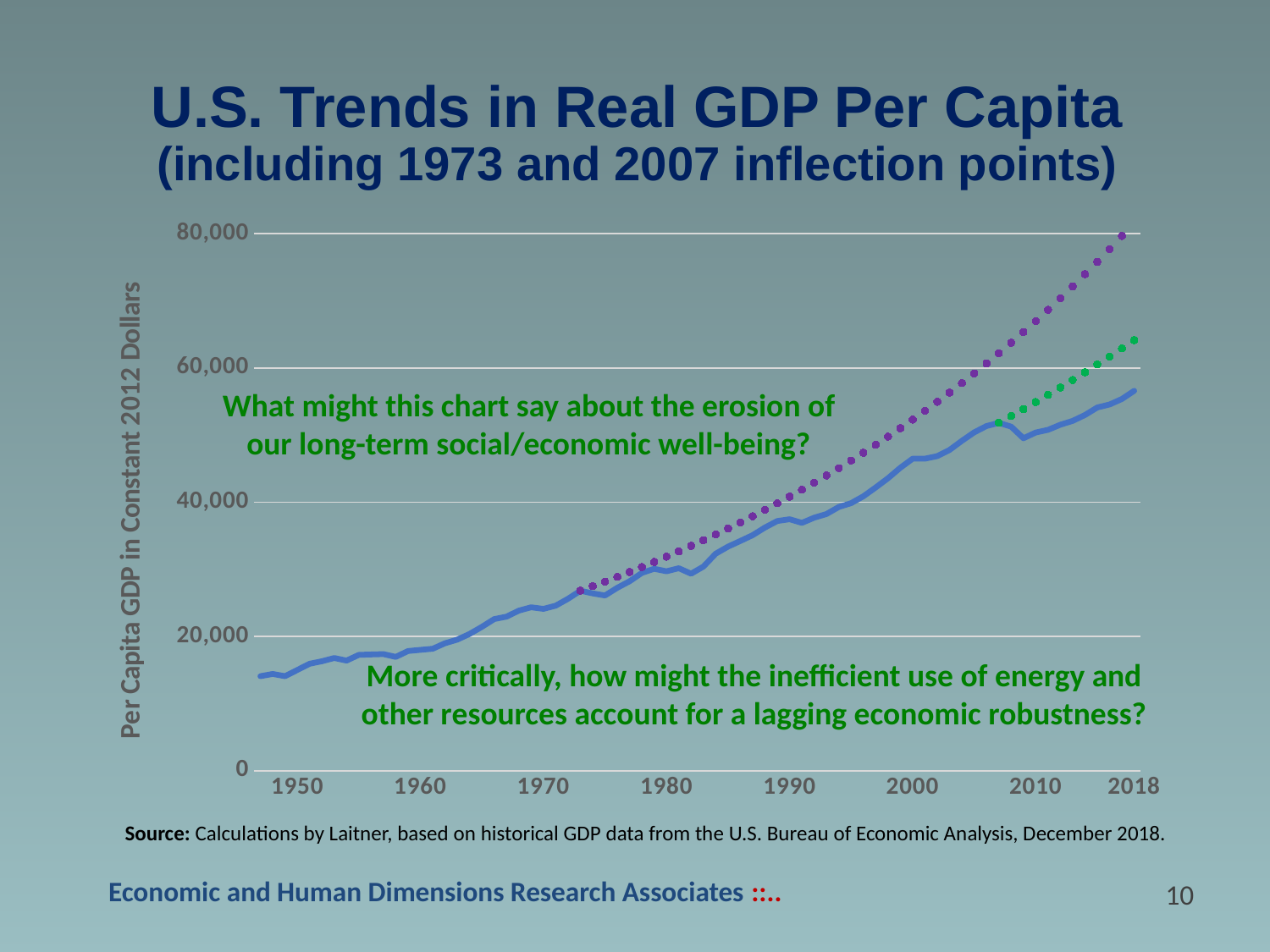
Is the value of the purple dotted line in 2018 greater or less than 60,000? greater Is the value of the solid blue line in 1990 greater or less than 40,000? less What kind of chart is shown on the slide? Line chart Is the value of the solid blue line in 2018 greater or less than 60,000? less What is the title of the chart? U.S. Trends in Real GDP Per Capita (including 1973 and 2007 inflection points) In which year does the solid blue line reach its highest value? 2018 In 2018, which is higher: the purple dotted line or the solid blue line? The purple dotted line Does the solid blue line generally rise or fall from 1950 to 2018? Rise What is the label on the vertical axis of the chart? Per Capita GDP in Constant 2012 Dollars